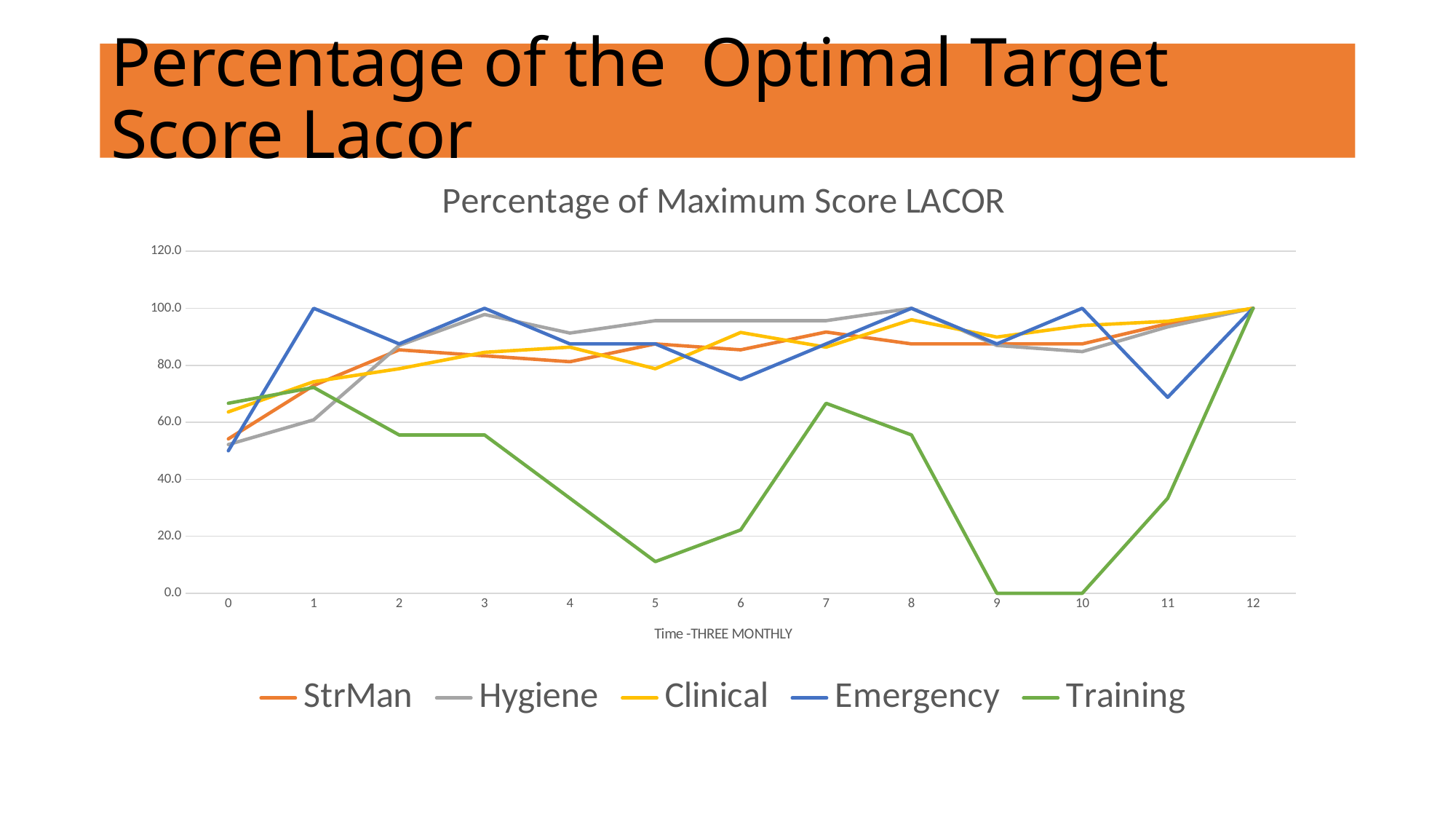
What kind of chart is shown on the slide? line chart How many series does the legend list? 5 What is the value for Training at time point 9? 0.0 What is the x-axis label of the chart? Time -THREE MONTHLY What is the value for Emergency at time point 1? 100.0 Is the value for Emergency at time point 11 greater or less than 80.0? less How many time points are plotted along the x axis? 13 Is the value for Training at time point 7 greater or less than 60.0? greater At time point 6, which is larger, the value for Clinical or the value for Emergency? Clinical Does the Training series rise or fall between time point 10 and time point 12? rise What is the title of the chart? Percentage of Maximum Score LACOR Which series has the lowest value at time point 5? Training